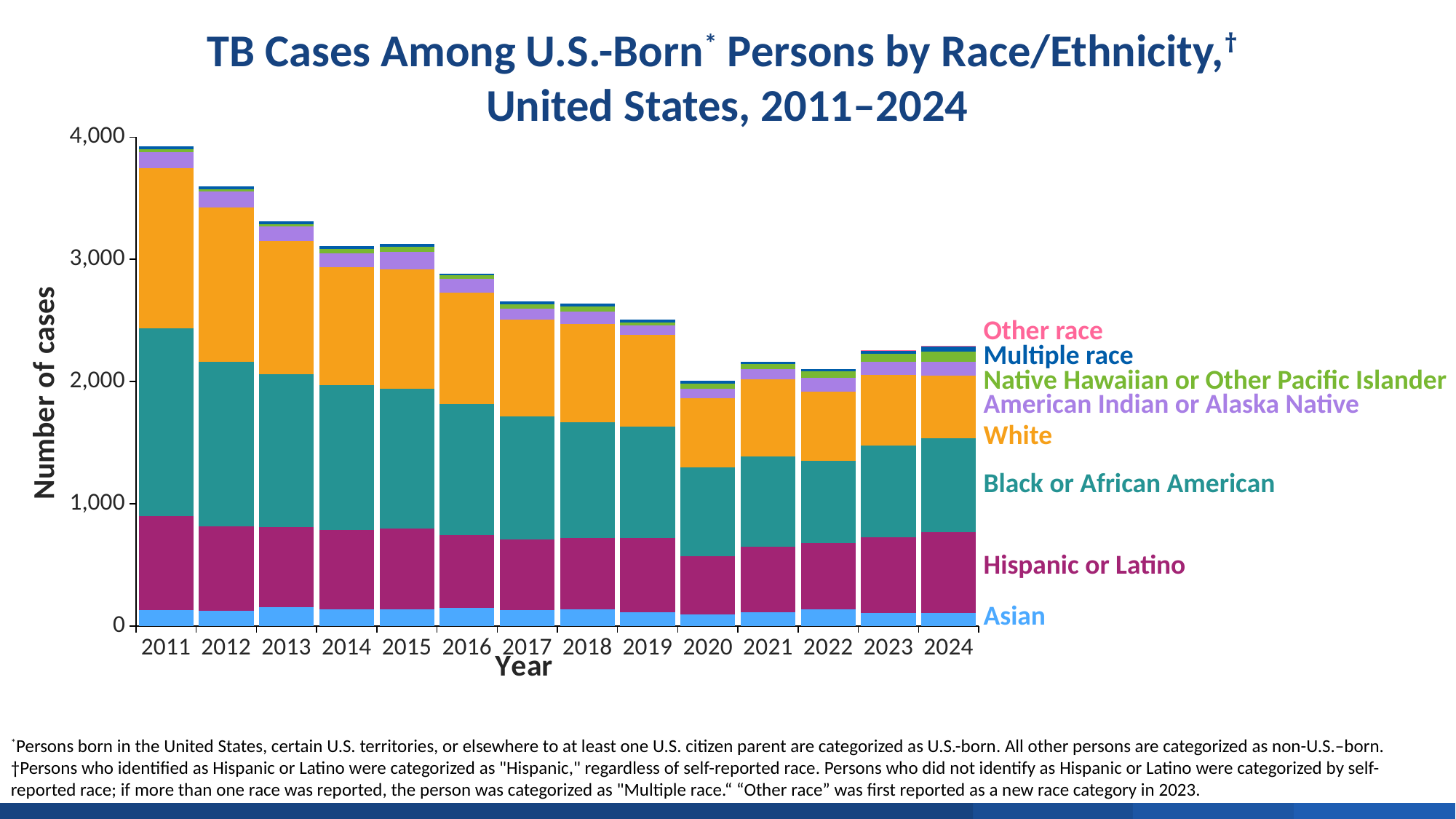
What kind of chart is shown on the slide? Stacked bar chart How many years are shown along the x axis of the chart? 14 What is the title of the y axis? Number of cases Which year has the lowest total number of TB cases among U.S.-born persons? 2020 Which year has a larger total number of cases, 2011 or 2024? 2011 Is the total number of cases in 2011 greater or less than 3,000? greater Is the total number of cases in 2016 greater or less than 3,000? less Do the total TB cases rise or fall from 2011 to 2020? Fall Is the total number of cases in 2019 greater or less than 2,000? greater Which series is plotted at the bottom of each stacked bar? Asian Which year has the highest total number of TB cases among U.S.-born persons? 2011 How many race/ethnicity series does the legend list? 8